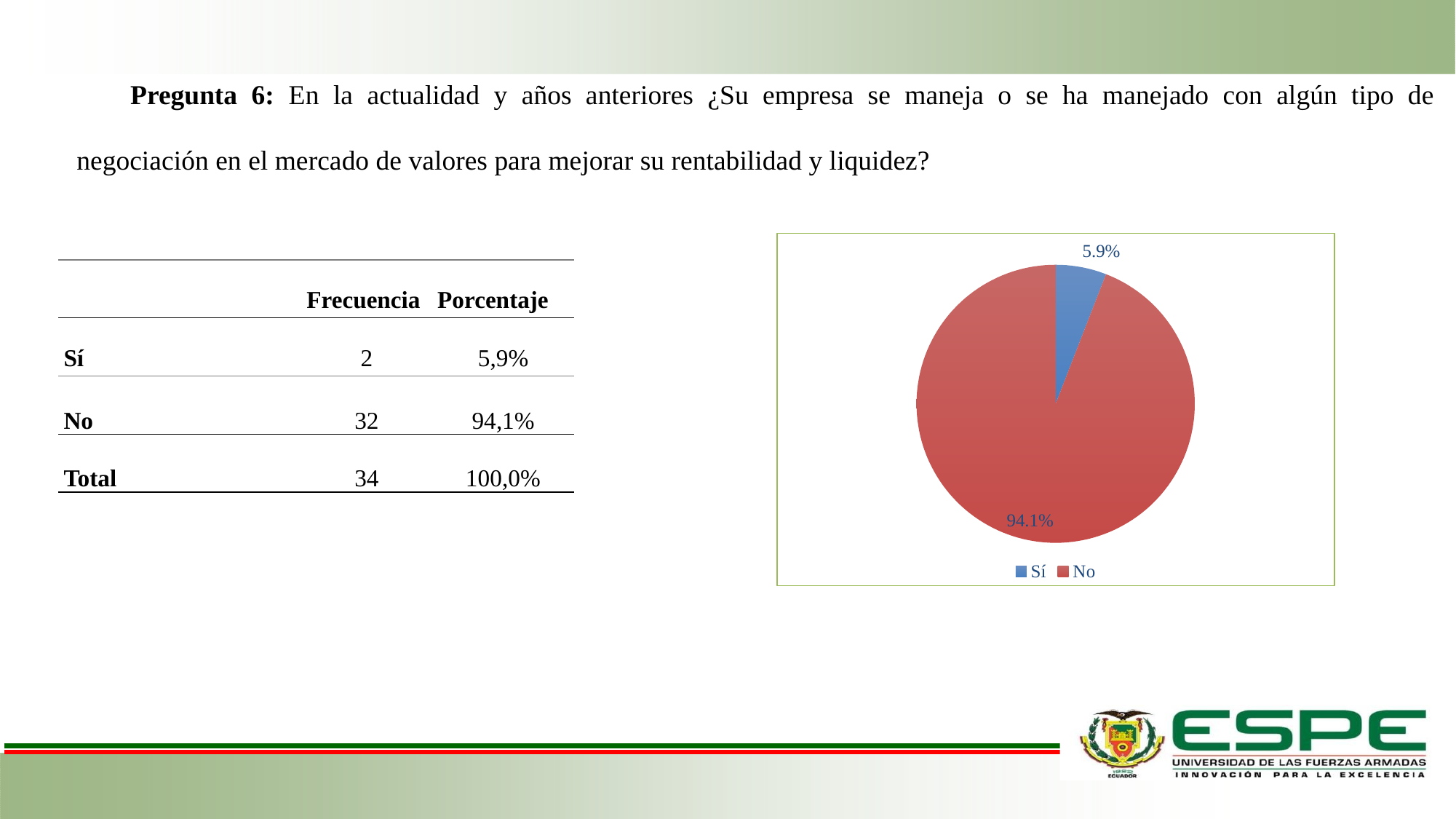
What colour is the No slice in the pie chart? red What percentage does the pie chart show for No? 94.1% What percentage does the pie chart show for Sí? 5.9% How many entries does the pie chart legend list? 2 How many slices does the pie chart have? 2 What colour is the Sí slice in the pie chart? blue Which is larger in the pie chart, Sí or No? No Which slice of the pie chart is the largest? No Which slice of the pie chart is the smallest? Sí What kind of chart is shown on the slide? pie chart What share of the pie does the No slice represent? 94.1% What is the difference in percentage points between the No slice and the Sí slice in the pie chart? 88.2